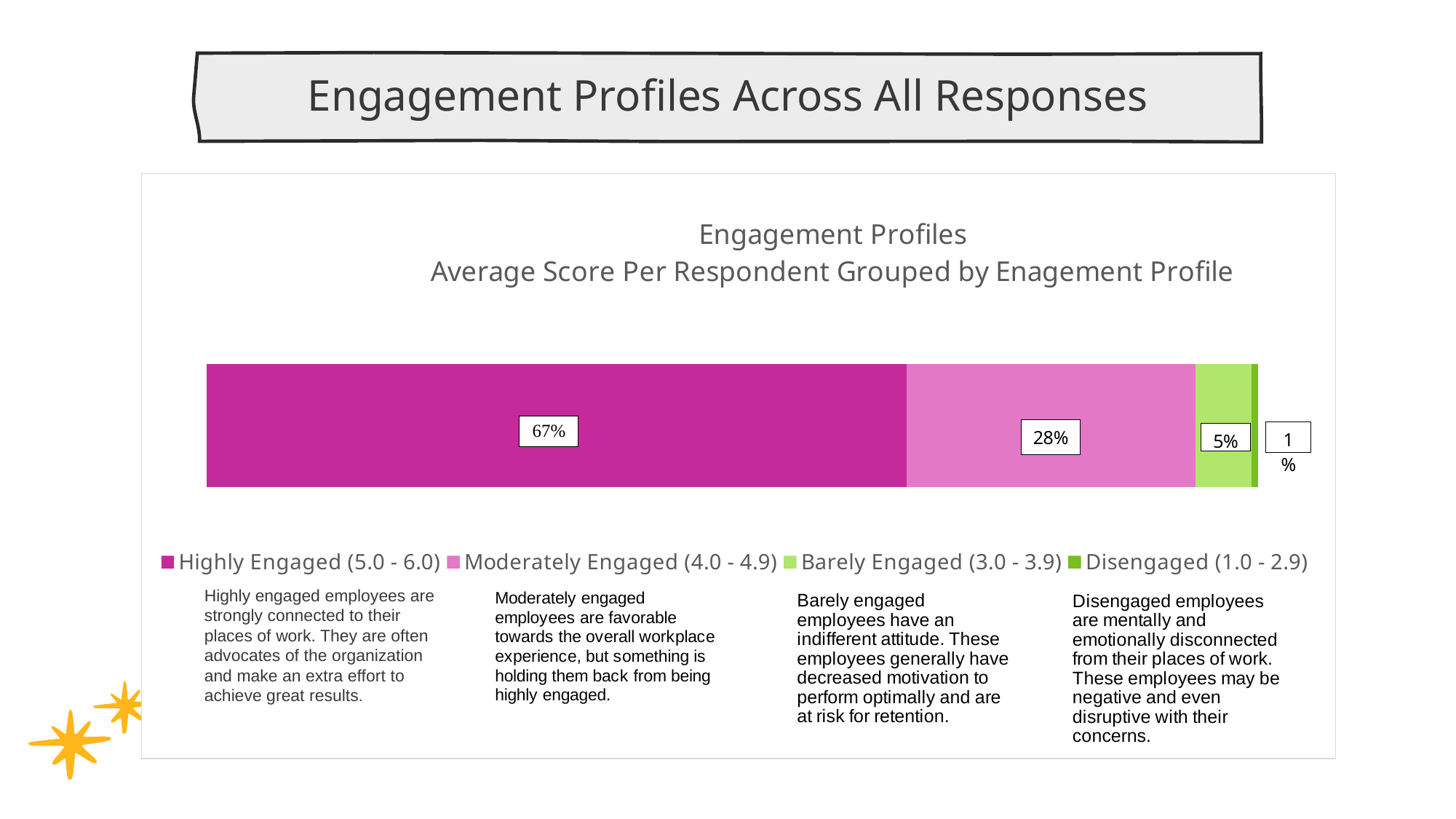
What percentage of respondents are Disengaged (1.0 - 2.9)? 1% What is the difference in percentage points between Highly Engaged and Moderately Engaged respondents? 39 What percentage of respondents are Barely Engaged (3.0 - 3.9)? 5% Which engagement profile has the smallest share of respondents? Disengaged (1.0 - 2.9) What is the total of all segments in the stacked bar? 101% Which engagement profile has the largest share of respondents? Highly Engaged (5.0 - 6.0) How many series does the legend list? 4 What colour represents the Highly Engaged (5.0 - 6.0) segment? Magenta What percentage of respondents are Moderately Engaged (4.0 - 4.9)? 28% Which is larger, the share of Moderately Engaged or Barely Engaged respondents? Moderately Engaged What percentage of respondents are Highly Engaged (5.0 - 6.0)? 67% What kind of chart is shown on the slide? Stacked bar chart